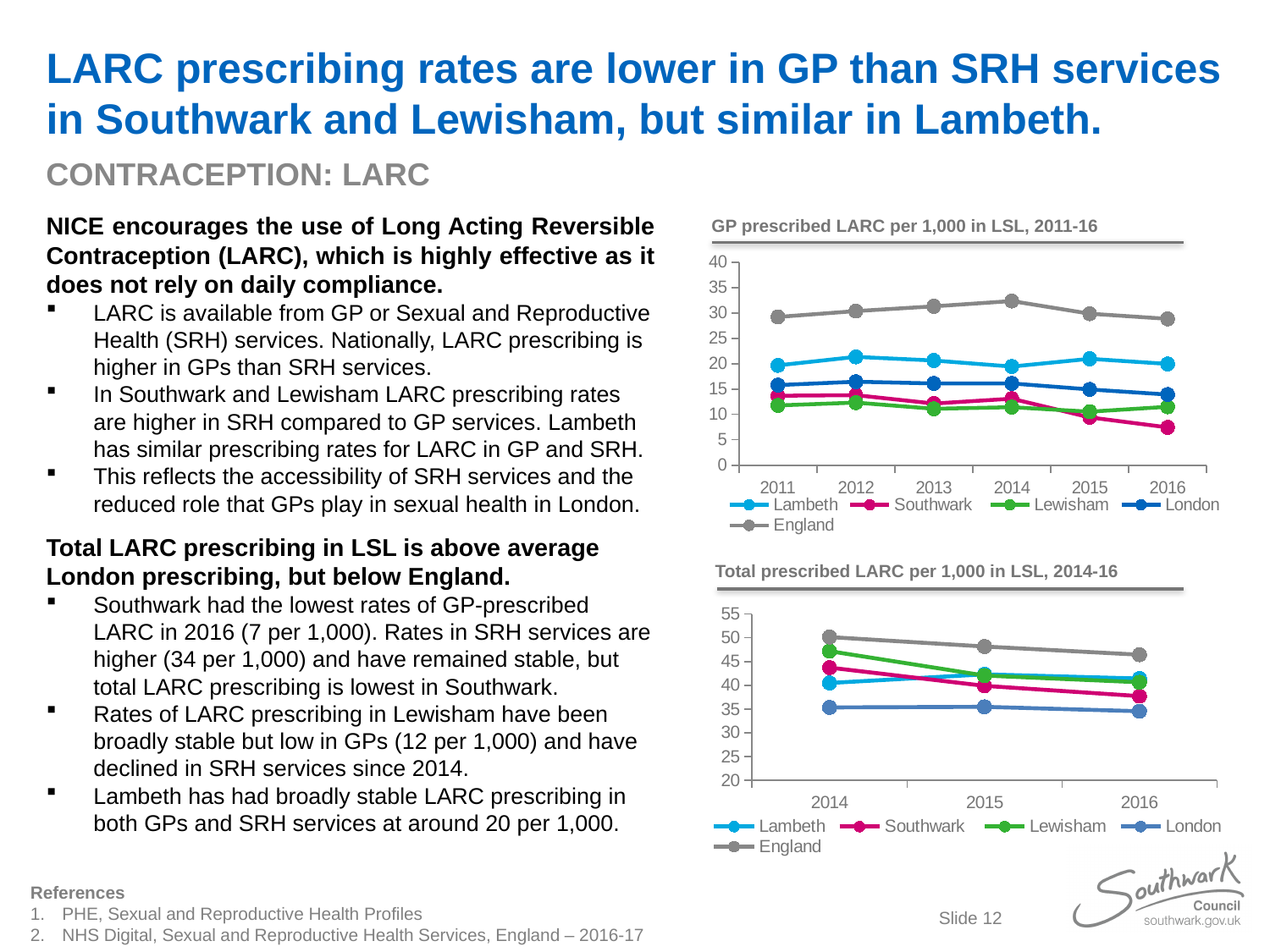
In the 'GP prescribed LARC per 1,000 in LSL, 2011-16' chart, is the value for Southwark in 2016 greater or less than 10? less In the 'GP prescribed LARC per 1,000 in LSL, 2011-16' chart, how many years are plotted on the x axis? 6 In the 'GP prescribed LARC per 1,000 in LSL, 2011-16' chart, is the value for England in 2014 greater or less than 30? greater In the 'Total prescribed LARC per 1,000 in LSL, 2014-16' chart, which series has the lowest value in 2016? London In the 'GP prescribed LARC per 1,000 in LSL, 2011-16' chart, which is larger in 2013, Lambeth or Lewisham? Lambeth What type of chart is the 'GP prescribed LARC per 1,000 in LSL, 2011-16' chart? Line chart In the 'GP prescribed LARC per 1,000 in LSL, 2011-16' chart, how many series does the legend list? 5 In the 'GP prescribed LARC per 1,000 in LSL, 2011-16' chart, does the Southwark line rise or fall between 2014 and 2016? Fall In the 'Total prescribed LARC per 1,000 in LSL, 2014-16' chart, is the value for Lewisham in 2014 greater or less than 45? greater In the 'GP prescribed LARC per 1,000 in LSL, 2011-16' chart, which series has the lowest value in 2016? Southwark In the 'GP prescribed LARC per 1,000 in LSL, 2011-16' chart, which series has the highest value in 2016? England In the 'Total prescribed LARC per 1,000 in LSL, 2014-16' chart, which series has the highest value in 2014? England